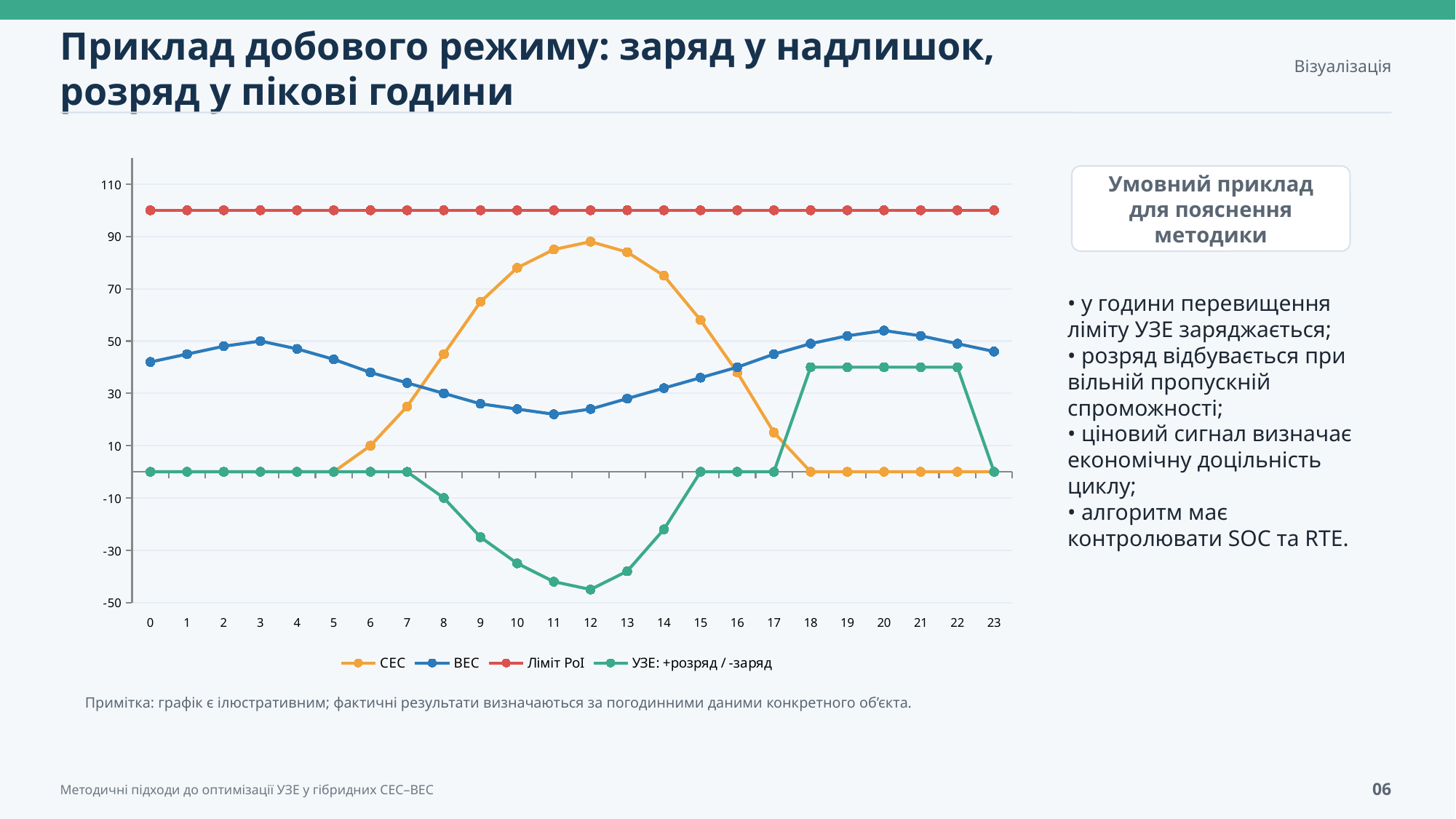
What kind of chart is shown on the slide? line chart What is the value of ВЕС at hour 3? 50 Is the value of ВЕС at hour 11 greater or less than 30? less How many series does the legend list? 4 Is the value of УЗЕ: +розряд / -заряд at hour 12 greater or less than -30? less At which hour does СЕС reach its highest value? 12 Does the СЕС line rise or fall between hour 6 and hour 12? rise What is the value of СЕС at hour 6? 10 How many hourly points are plotted along the x axis? 24 Is the value of СЕС at hour 12 greater or less than 70? greater What is the value of УЗЕ: +розряд / -заряд at hour 8? -10 At hour 0, which is larger: СЕС or ВЕС? ВЕС